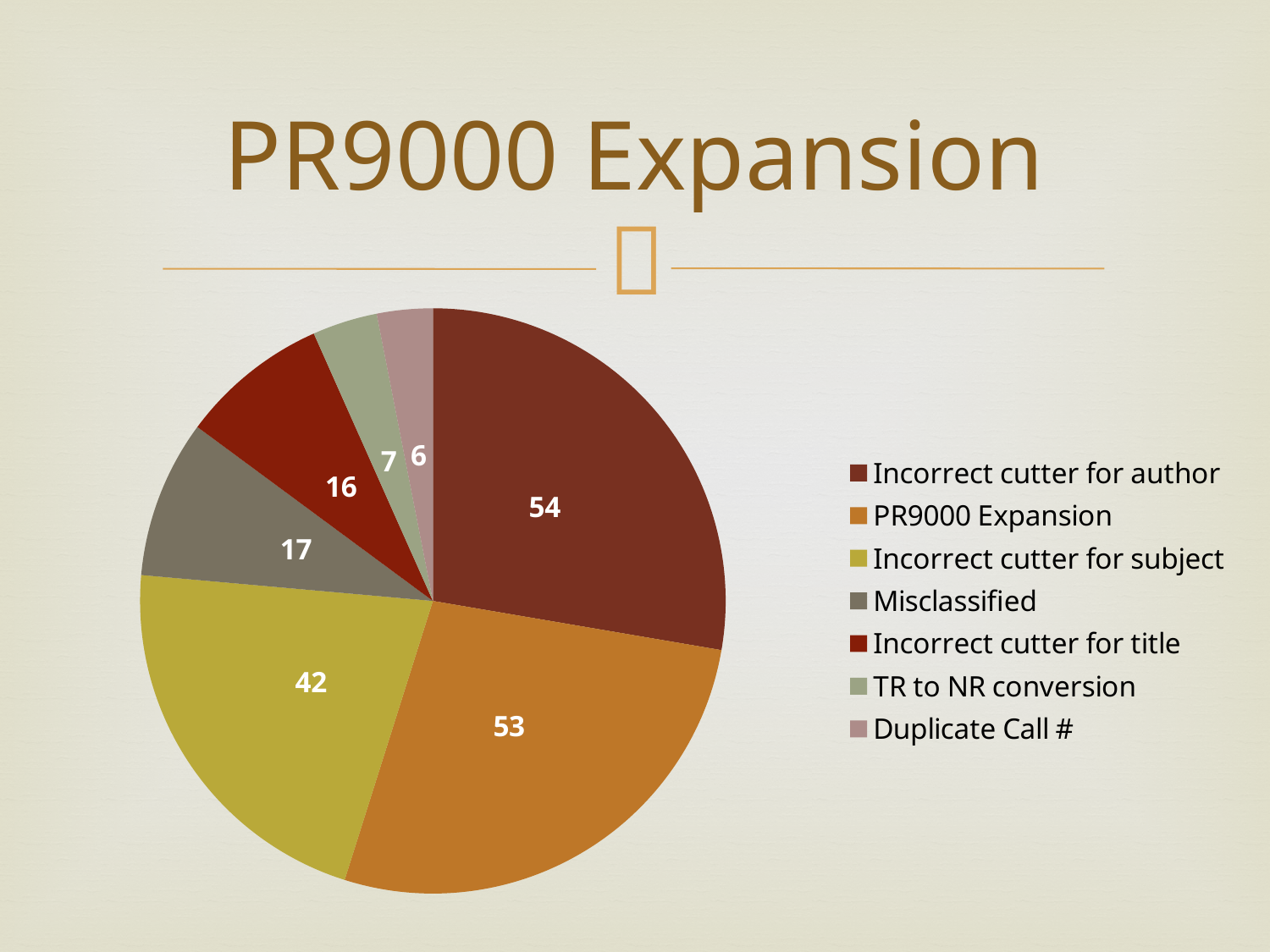
What is the value for Incorrect cutter for author? 54 What kind of chart is shown on the slide? pie chart Which is larger, the value for Misclassified or the value for Incorrect cutter for title? Misclassified Which category has the smallest slice of the pie? Duplicate Call # How many categories does the pie chart have? 7 What is the total of all the slices in the pie chart? 195 What is the value for Incorrect cutter for subject? 42 Which category has the largest slice of the pie? Incorrect cutter for author What is the value for Misclassified? 17 What is the value for Duplicate Call #? 6 What is the difference between the values for PR9000 Expansion and Incorrect cutter for subject? 11 What is the value for PR9000 Expansion? 53